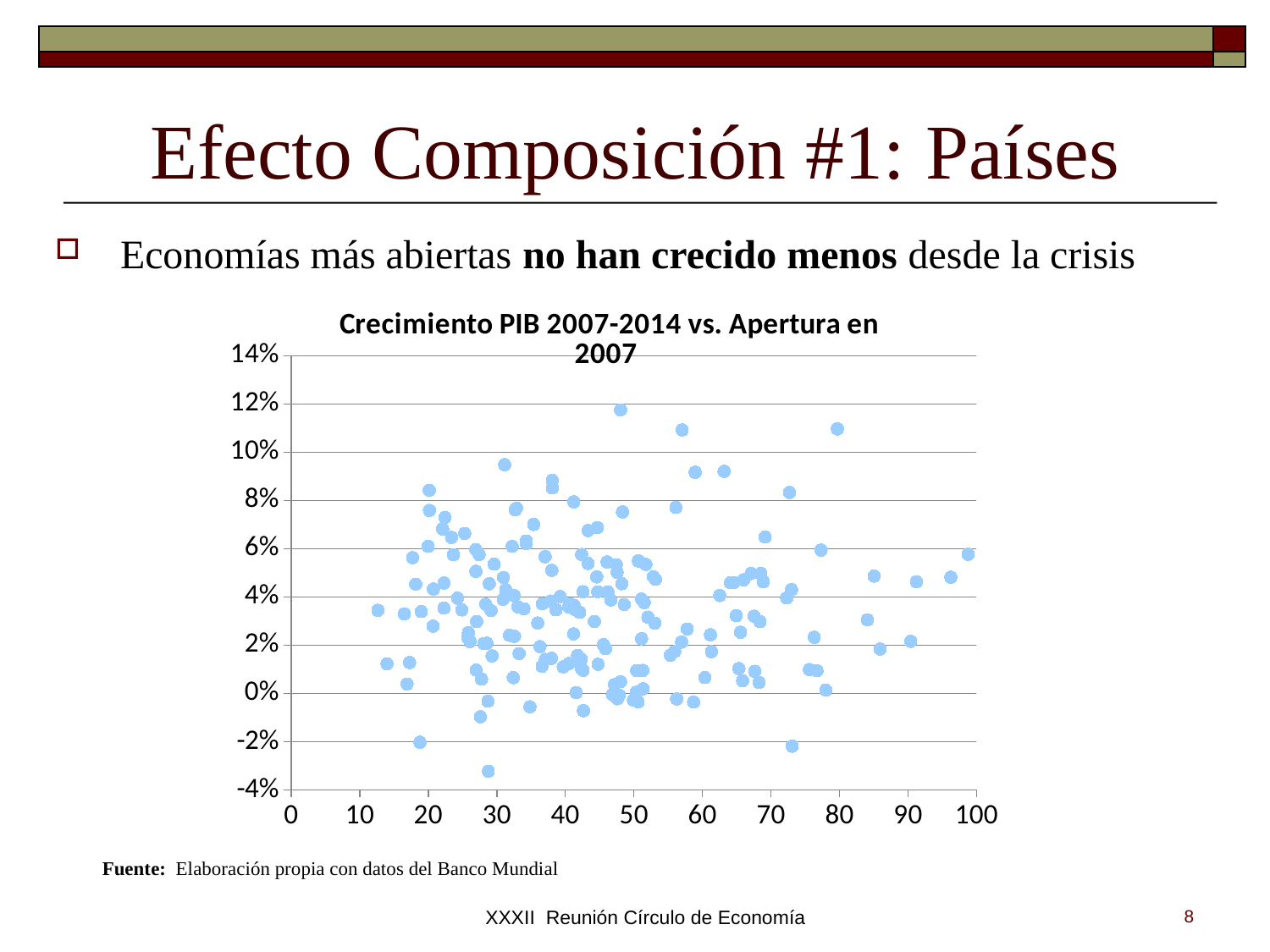
Is the highest point in the chart greater or less than 10%? greater Is the point with the largest x value (near 100) greater or less than 4% on the vertical axis? greater What is the title of the chart? Crecimiento PIB 2007-2014 vs. Apertura en 2007 Is the point with the smallest x value (near 12) greater or less than 4% on the vertical axis? less What is the highest value shown on the vertical axis of the chart? 14% What kind of chart is shown on the slide? scatter chart Do the plotted values show a clear rising or falling trend along the x axis? no clear trend